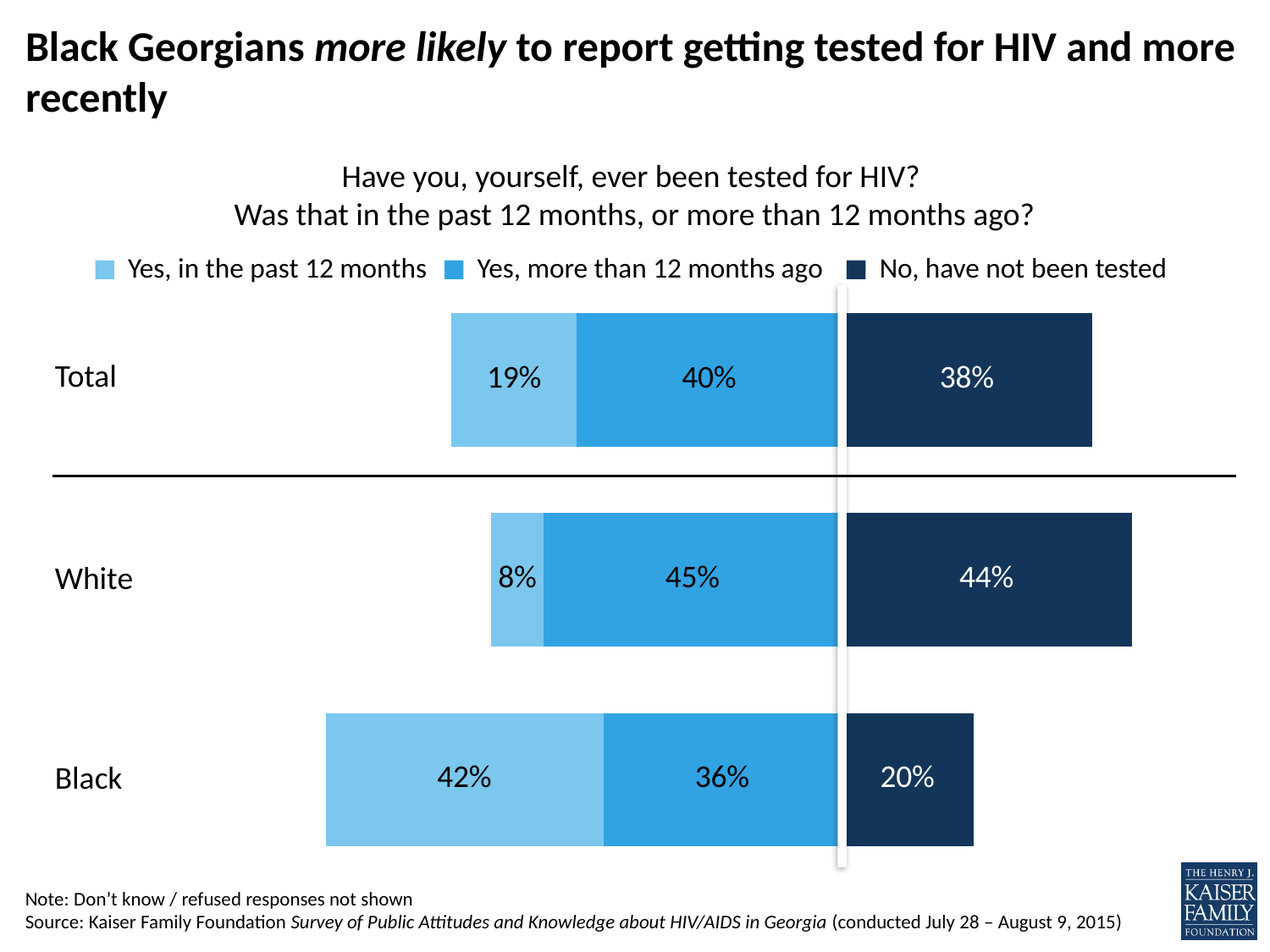
What is the total of the three segments in the Black bar? 98% How many groups (bars) are shown in the chart? 3 Which group has the highest share saying 'Yes, in the past 12 months'? Black How many series does the legend list? 3 What is the difference between the White and Black percentages for 'No, have not been tested'? 24 percentage points Which group has the lowest share saying 'No, have not been tested'? Black Which legend entry is shown in the darkest blue colour? No, have not been tested What kind of chart is shown on the slide? Stacked bar chart What is the value for 'Yes, more than 12 months ago' in the Total bar? 40% What percentage of White respondents said they have not been tested for HIV? 44% Is the 'Yes, in the past 12 months' value larger for White or for Total? Total What percentage of Black respondents said they were tested for HIV in the past 12 months? 42%